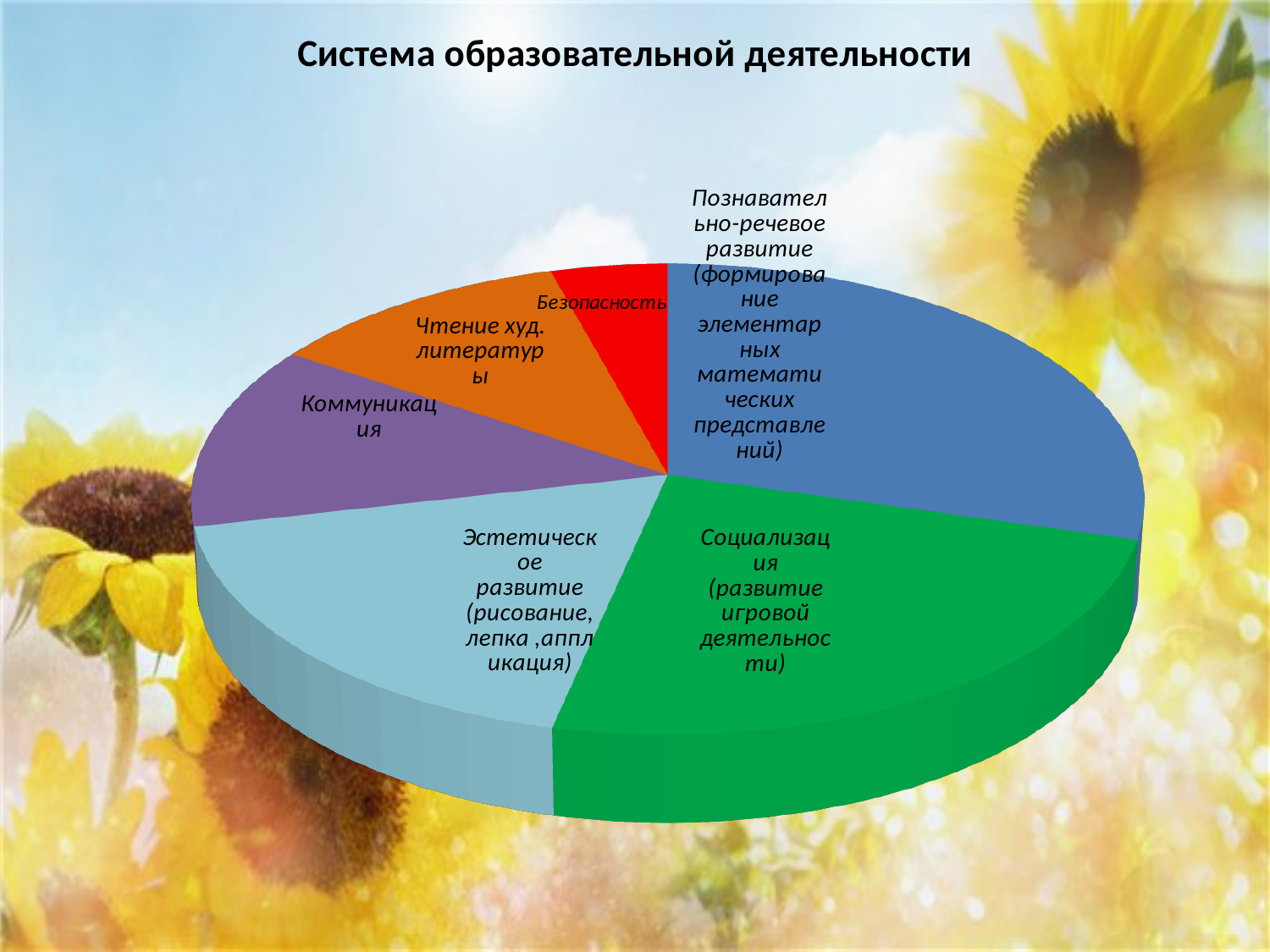
What colour is the Безопасность slice of the pie chart? red Which slice is larger: Безопасность or Социализация (развитие игровой деятельности)? Социализация (развитие игровой деятельности) Which slice is larger: Безопасность or Чтение худ. литературы? Чтение худ. литературы What kind of chart is shown on the slide? pie chart Which slice is larger: Эстетическое развитие (рисование, лепка, аппликация) or Чтение худ. литературы? Эстетическое развитие (рисование, лепка, аппликация) What is the title of the slide containing the pie chart? Система образовательной деятельности How many slices does the pie chart have? 6 Which slice of the pie chart is the smallest? Безопасность